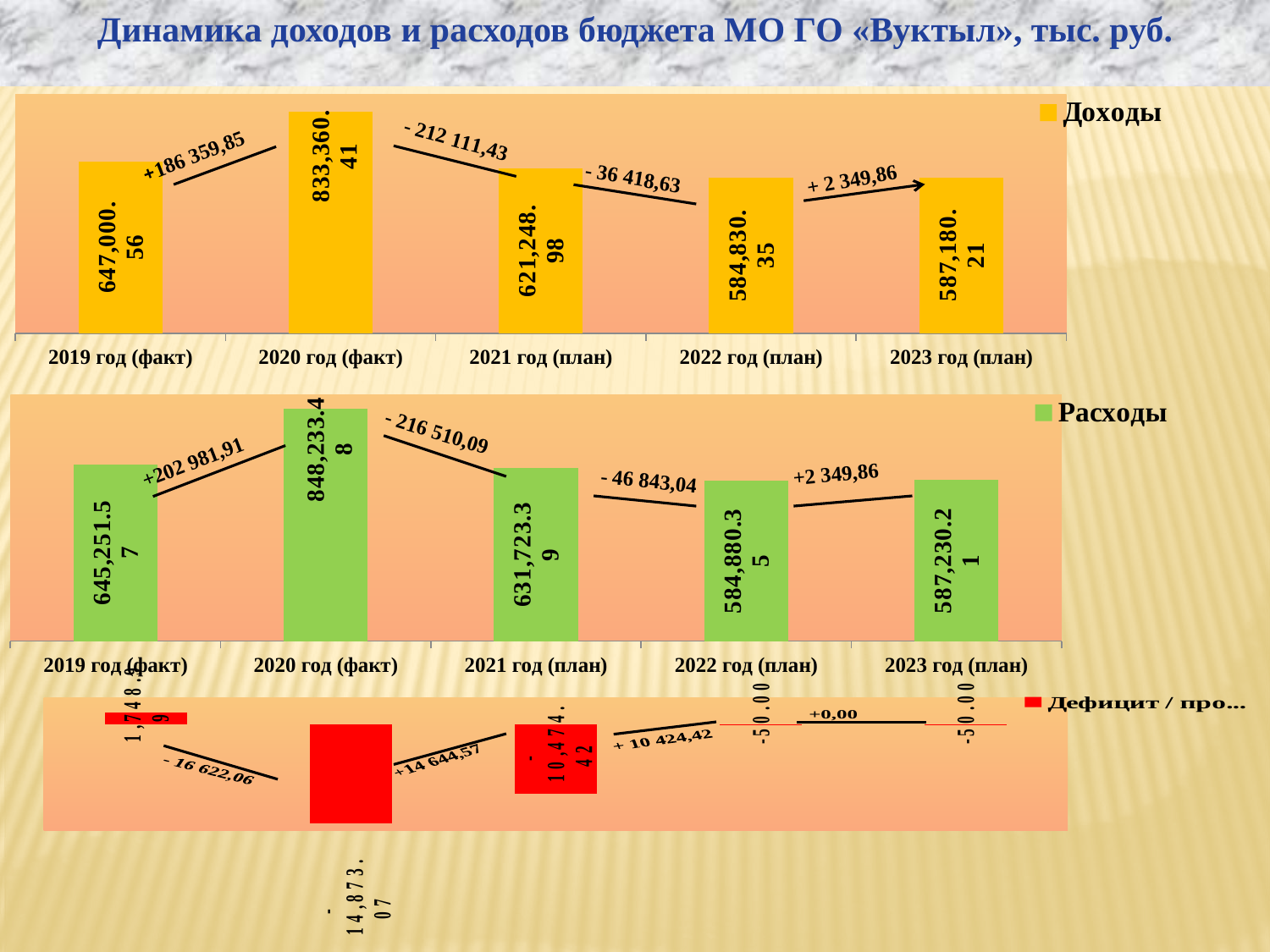
In the Расходы chart, which year has the highest value? 2020 год (факт) In the Доходы chart, what is the value for 2023 год (план)? 587,180.21 In the Доходы chart, what is the value for 2020 год (факт)? 833,360.41 In the Доходы chart, which year has the highest value? 2020 год (факт) How many categories (years) are shown in the Расходы chart? 5 What kind of chart is the Доходы chart? bar chart In the Расходы chart, what is the value for 2021 год (план)? 631,723.39 In the bottom Дефицит / профицит chart, what is the value for 2020 год (факт)? -14,873.07 In the Доходы chart, which year has the lowest value? 2022 год (план) In the Доходы chart, which is larger: the value for 2019 год (факт) or 2021 год (план)? 2019 год (факт) In the bottom Дефицит / профицит chart, what is the value for 2022 год (план)? -50.00 In the Доходы chart, by how much does the value change from 2019 год (факт) to 2020 год (факт), as annotated on the slide? +186 359,85